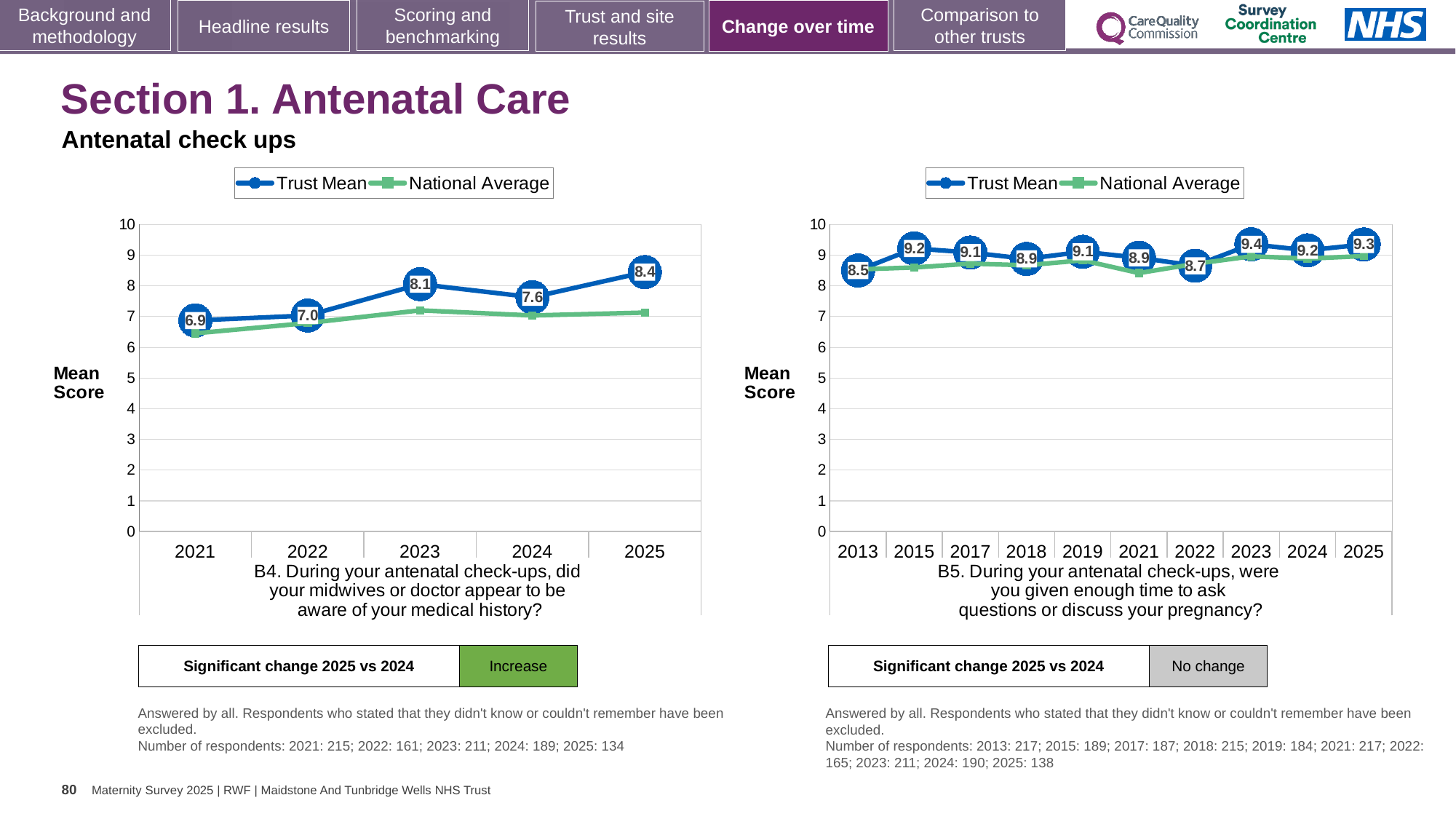
In the B5 chart (right), is the Trust Mean score for 2022 larger or smaller than the score for 2023? smaller In the B5 chart (right), what is the Trust Mean score for 2013? 8.5 In the B4 chart (left), which year has the lowest Trust Mean score? 2021 In the B4 chart (left), how many years are shown on the x axis? 5 In the B4 chart (left), what is the Trust Mean score for 2025? 8.4 In the B5 chart (right), how many years are shown on the x axis? 10 In the B5 chart (right), which year has the highest Trust Mean score? 2023 What type of chart is the B4 chart on the left? Line chart In the B4 chart (left), what is the Trust Mean score for 2021? 6.9 In the B5 chart (right), how many series does the legend list? 2 In the B4 chart (left), is the National Average value for 2021 greater or less than 7? less In the B4 chart (left), what is the difference between the Trust Mean scores for 2025 and 2024? 0.8